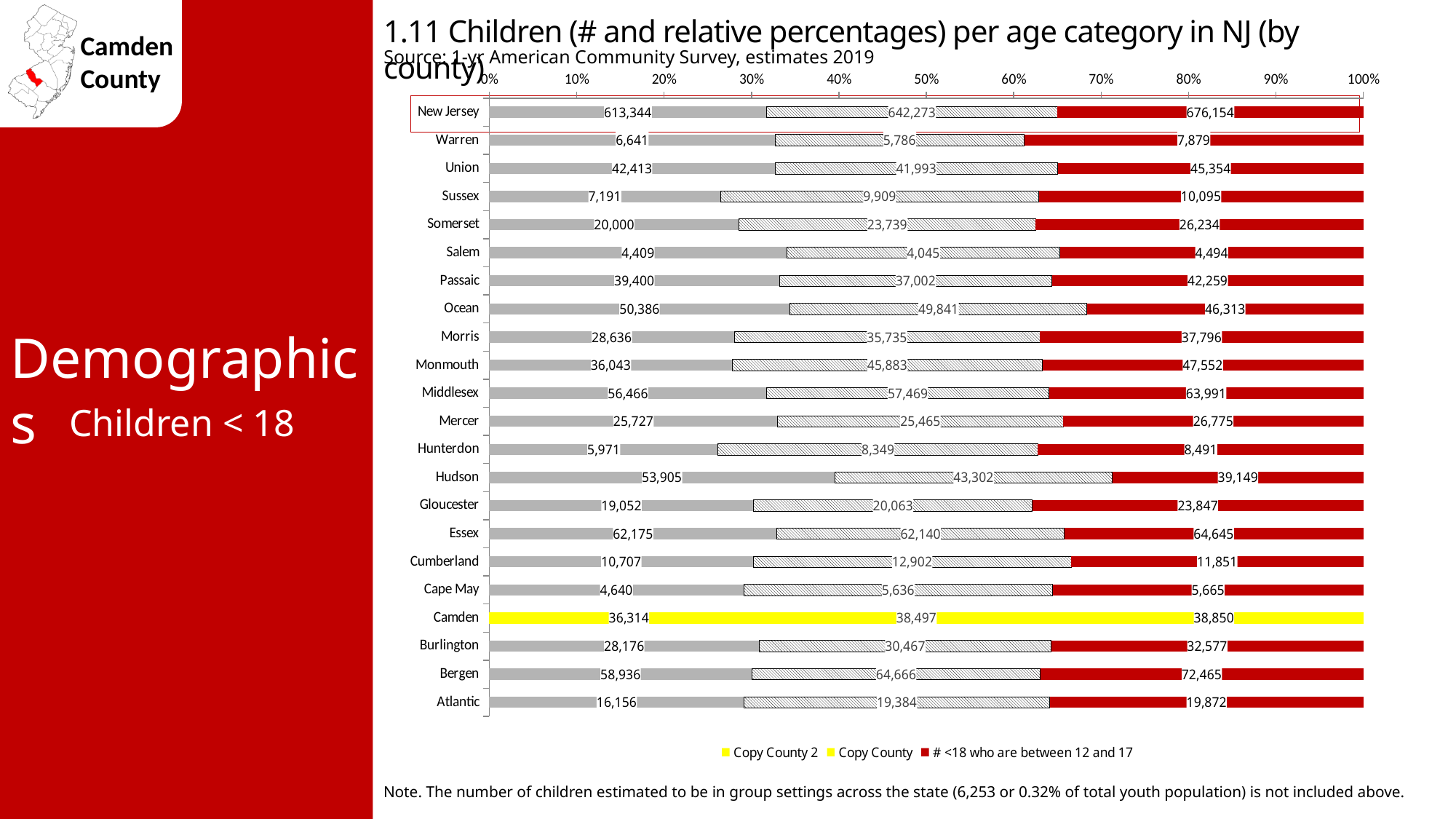
What is the value of the middle (hatched) segment for Bergen? 64,666 What kind of chart is shown on the slide? Stacked bar chart How many bars (counties plus the New Jersey total) are shown in the chart? 22 How many series does the legend list? 3 What is the total of the three segments of the Camden bar? 113,661 Among the counties (excluding the New Jersey total), which has the highest value for # <18 who are between 12 and 17? Bergen What is the value of the red segment (# <18 who are between 12 and 17) for Camden? 38,850 What is the value of the leftmost segment of the New Jersey bar? 613,344 Among the counties (excluding the New Jersey total), which has the lowest value for # <18 who are between 12 and 17? Salem What is the difference between Bergen's and Camden's values for # <18 who are between 12 and 17? 33,615 Which is larger: the leftmost segment value for Hudson or for Ocean? Hudson Is the share of the leftmost segment in the Hudson bar greater or less than 30%? greater